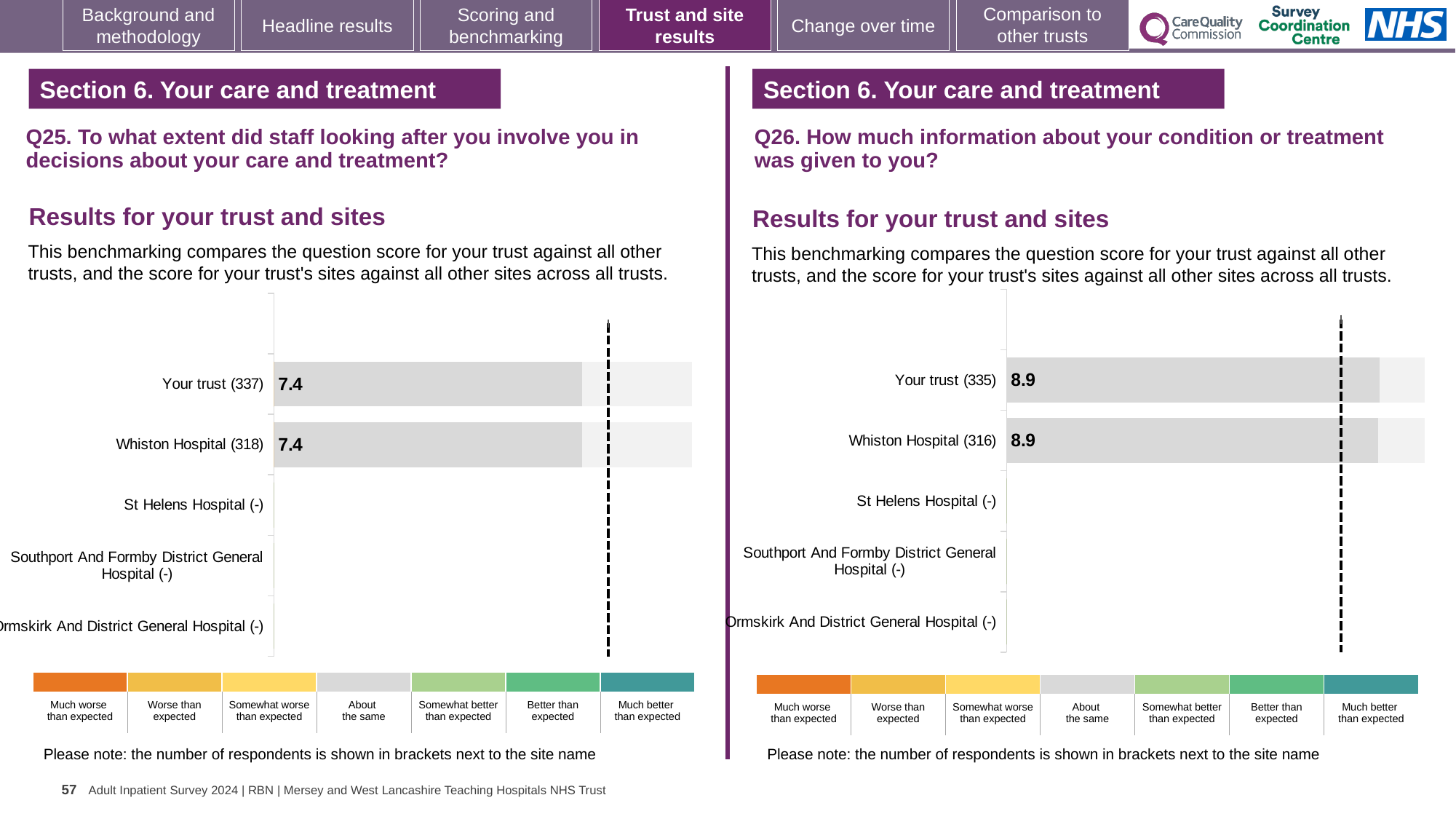
In the Q26 chart on the right, how many respondents are shown in brackets for Whiston Hospital? 316 In the Q25 chart on the left, what is the score for Your trust? 7.4 In the Q25 chart on the left, what is the difference between the scores for Your trust and Whiston Hospital? 0 In the Q26 chart on the right, what is the score for Whiston Hospital? 8.9 What kind of chart is used for the Q25 results on the left? Bar chart In the Q25 chart on the left, what is the score for Whiston Hospital? 7.4 In the Q26 chart on the right, what is the score for Your trust? 8.9 How many site/trust categories are listed on the y axis of the Q25 chart on the left? 5 In the Q25 chart on the left, how many respondents are shown in brackets for Your trust? 337 In the Q26 chart on the right, what is the difference between the scores for Your trust and Whiston Hospital? 0 In the Q26 chart on the right, which category is shown with a score of 8.9 alongside Your trust? Whiston Hospital (316) How many site/trust categories are listed on the y axis of the Q26 chart on the right? 5